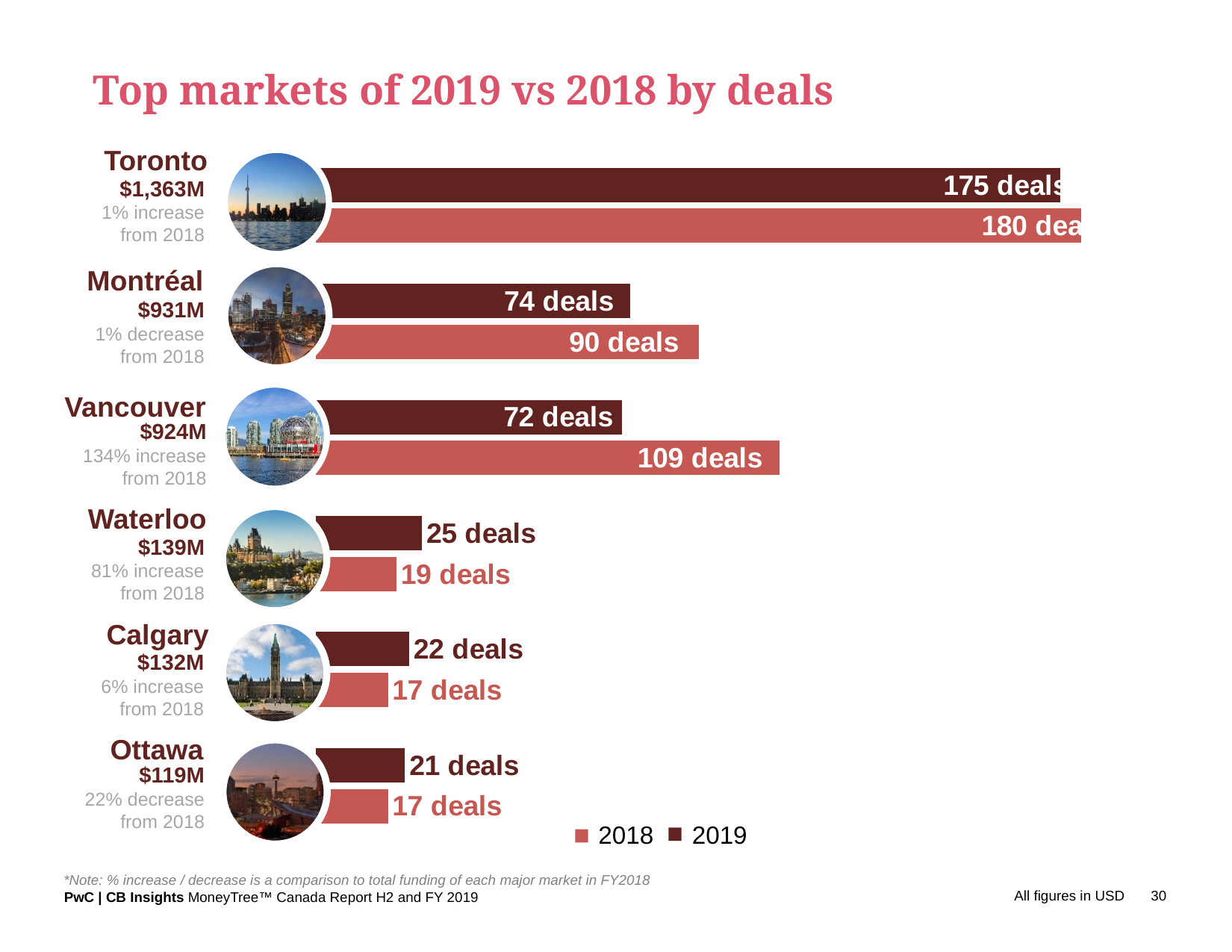
What is the difference between Montréal's 2018 and 2019 deal counts? 16 deals Which market had the highest number of deals in 2019? Toronto How many series does the legend list? 2 How many deals did Waterloo have in 2019? 25 deals How many deals did Montréal have in 2019? 74 deals What is the difference between Vancouver's 2018 and 2019 deal counts? 37 deals Which is larger: Calgary's deals in 2019 or Calgary's deals in 2018? 2019 (22 deals) Which market had the lowest number of deals in 2018? Calgary and Ottawa (17 deals each) What kind of chart is shown on the slide? Bar chart How many deals did Ottawa have in 2018? 17 deals How many deals did Vancouver have in 2018? 109 deals How many markets are shown in the chart? 6